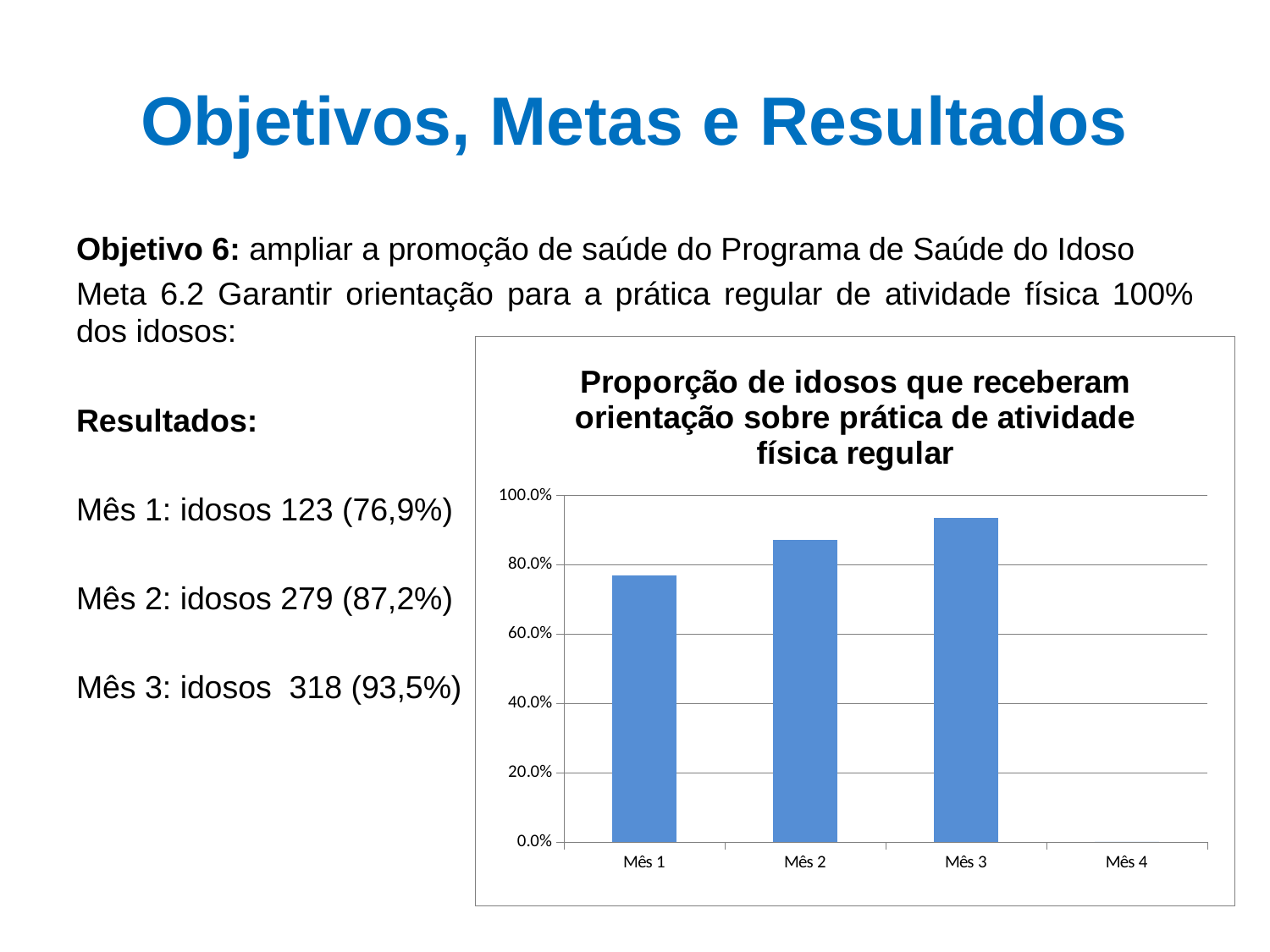
How many bars are plotted in the chart? 3 Is the value for Mês 2 greater or less than 80.0%? greater Is the value for Mês 3 greater or less than 100.0%? less Is the value for Mês 1 greater or less than 80.0%? less According to the slide text, what proportion of idosos received orientation in Mês 3? 93,5% Among the months with a plotted bar, which has the lowest value? Mês 1 Which is larger, the value for Mês 2 or the value for Mês 3? Mês 3 Which month has the highest bar in the chart? Mês 3 How many category labels are shown on the x axis of the chart? 4 What kind of chart is shown on the slide? bar chart What is the title of the chart? Proporção de idosos que receberam orientação sobre prática de atividade física regular Do the bar values rise or fall from Mês 1 to Mês 3? rise